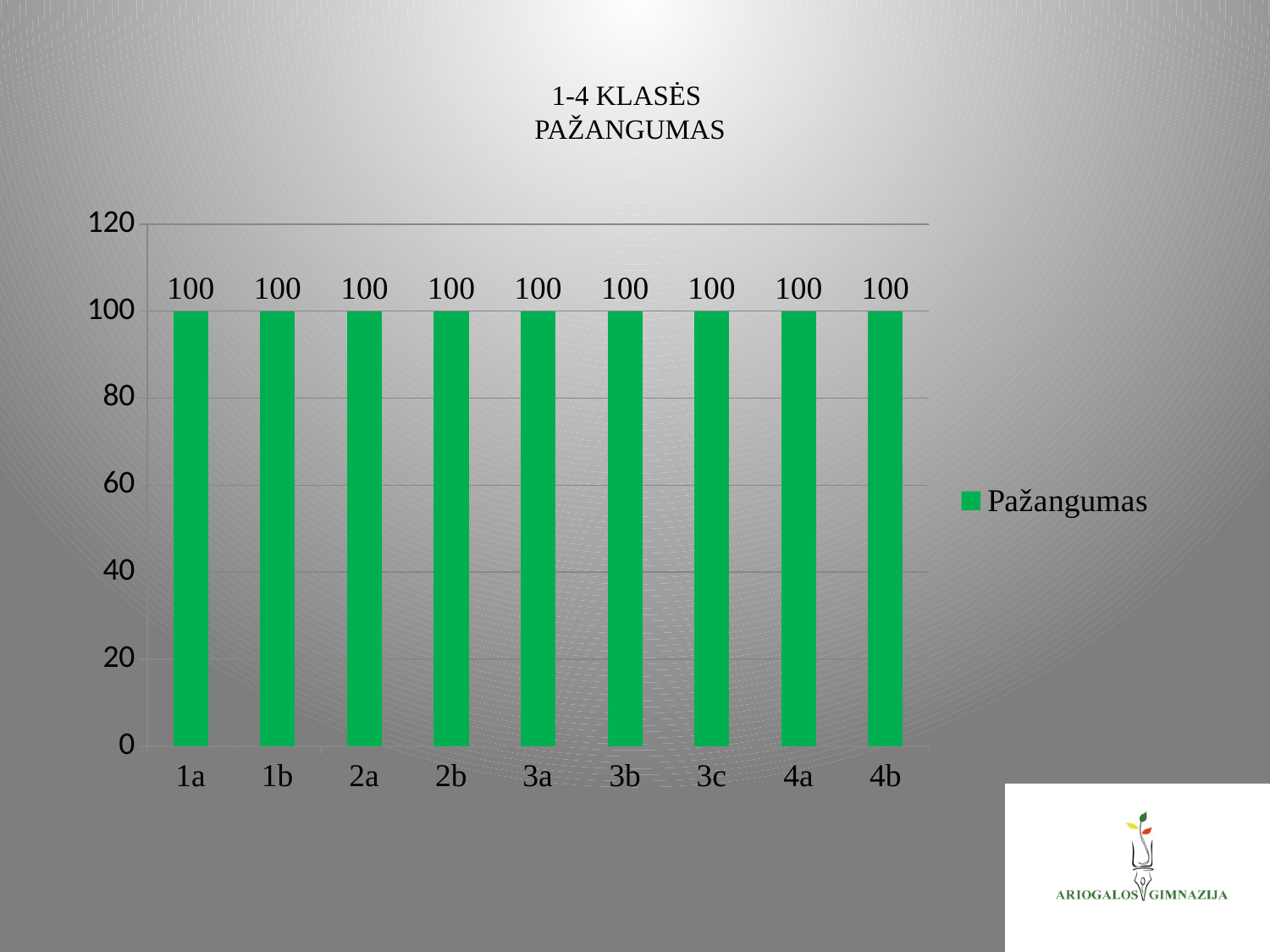
Is the value for 4a greater or less than 120? less How many classes are shown on the x axis? 9 What is the title of the chart? 1-4 KLASĖS PAŽANGUMAS Do the values rise, fall or stay the same from 1a to 4b? stay the same What series name is shown in the legend? Pažangumas What is the Pažangumas value for class 4b? 100 How many series does the legend list? 1 Is the value for 2b greater or less than 80? greater What is the Pažangumas value for class 1a? 100 What kind of chart is shown on the slide? bar chart What is the difference between the values for 2a and 3b? 0 What is the Pažangumas value for class 3c? 100